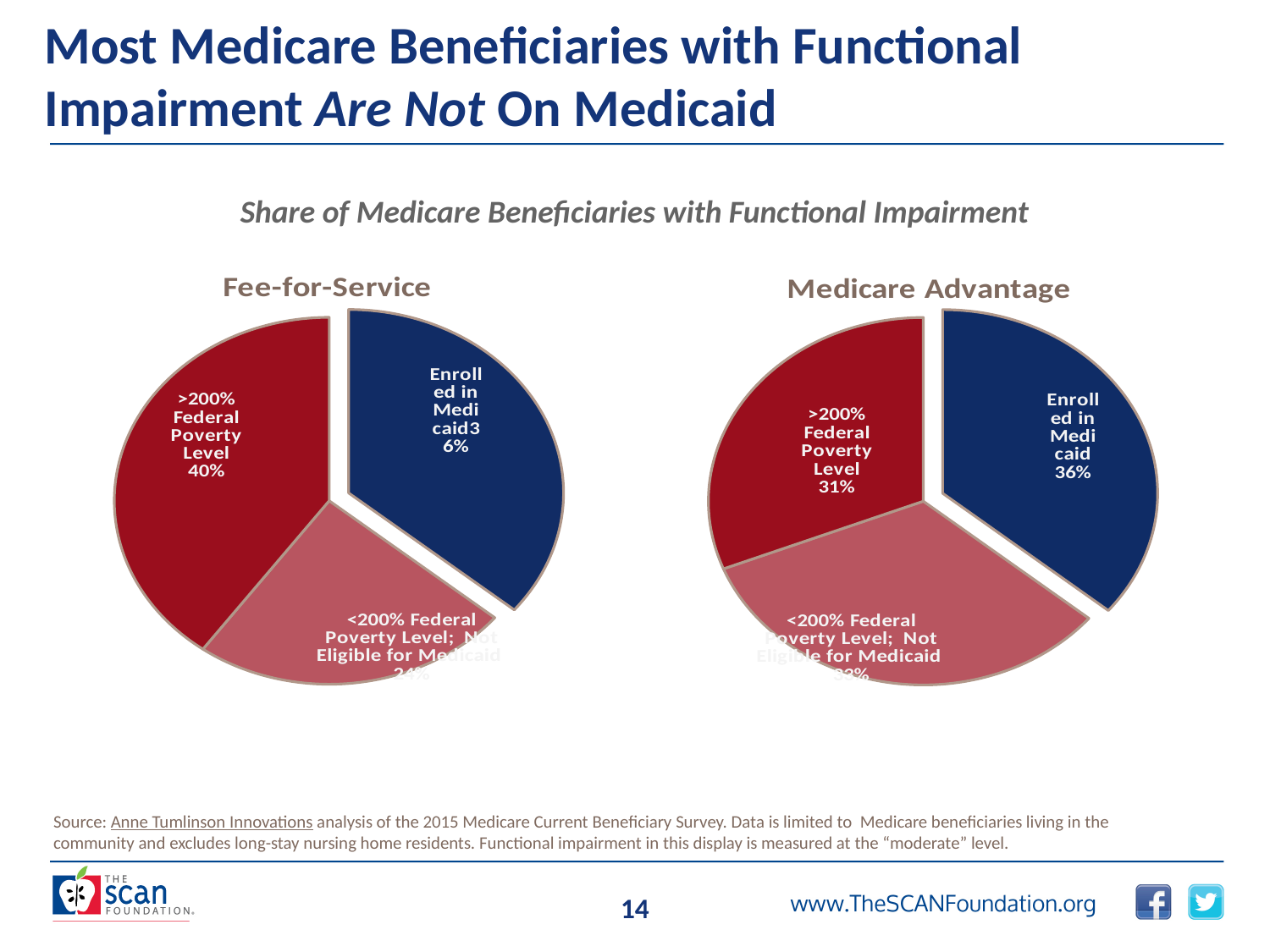
What is the overall title shown above the two pie charts? Share of Medicare Beneficiaries with Functional Impairment How many slices does the Medicare Advantage pie chart have? 3 In the Medicare Advantage chart, what share is >200% Federal Poverty Level? 31% Which chart has the larger share for >200% Federal Poverty Level, Fee-for-Service or Medicare Advantage? Fee-for-Service In the Fee-for-Service chart, which slice is the smallest? <200% Federal Poverty Level; Not Eligible for Medicaid In the Medicare Advantage chart, how many percentage points larger is the Enrolled in Medicaid slice than the >200% Federal Poverty Level slice? 5 percentage points In the Medicare Advantage chart, what share is Enrolled in Medicaid? 36% In the Fee-for-Service chart, how many percentage points larger is the >200% Federal Poverty Level slice than the Enrolled in Medicaid slice? 4 percentage points In the Fee-for-Service chart, which slice is the largest? >200% Federal Poverty Level In the Fee-for-Service chart, what share is >200% Federal Poverty Level? 40% What kind of charts are shown on the slide? Pie charts In the Fee-for-Service chart, what share is Enrolled in Medicaid? 36%